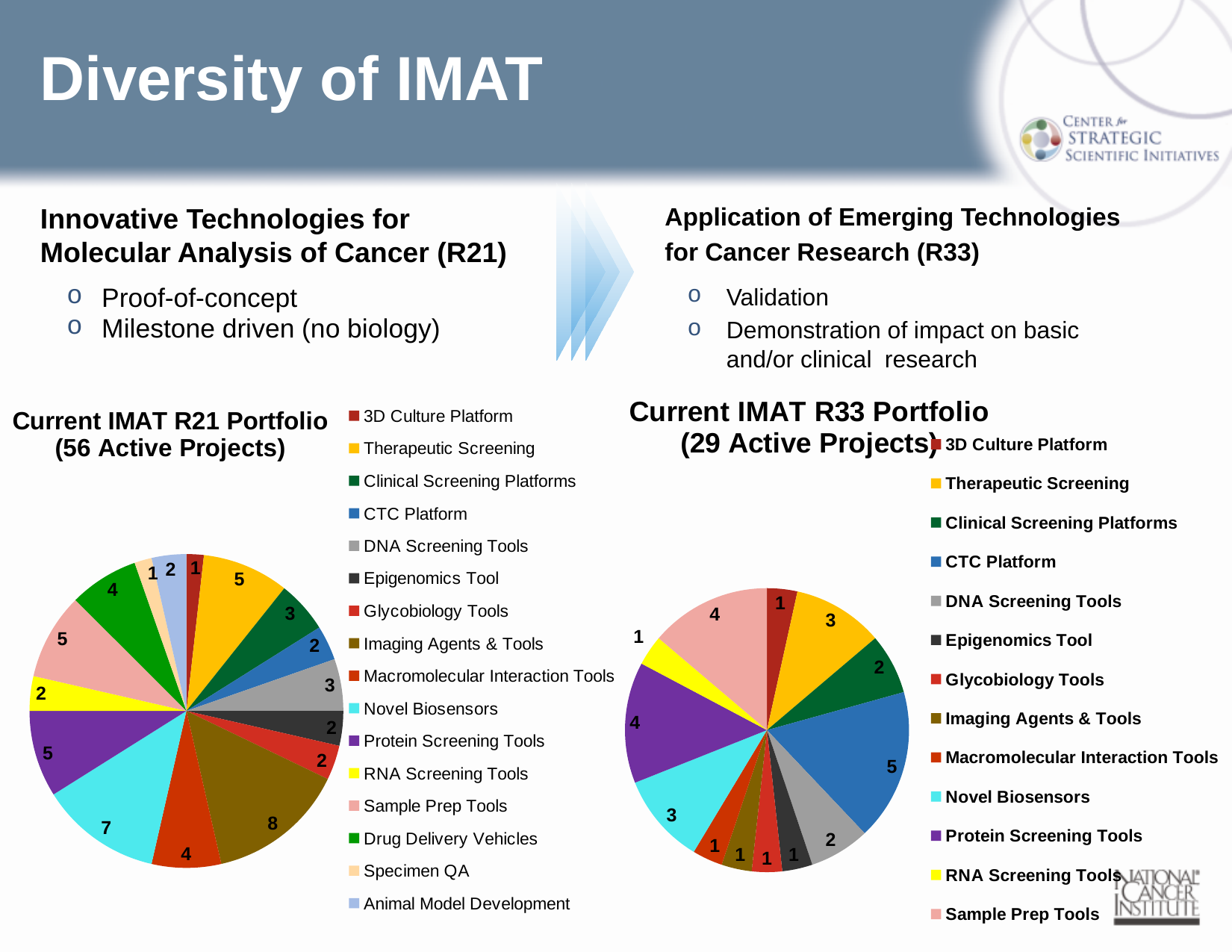
In the Current IMAT R33 Portfolio chart, which category has the largest slice? CTC Platform In the Current IMAT R21 Portfolio chart, what is the difference between Imaging Agents & Tools and Macromolecular Interaction Tools? 4 In the Current IMAT R33 Portfolio chart, how many projects are in CTC Platform? 5 What type of chart is used for the Current IMAT R33 Portfolio? Pie chart In the Current IMAT R21 Portfolio chart, how many projects are in Imaging Agents & Tools? 8 In the Current IMAT R33 Portfolio chart, which is larger, Therapeutic Screening or Protein Screening Tools? Protein Screening Tools In the Current IMAT R21 Portfolio chart, what share of the 56 projects is Novel Biosensors? 12.5% In the Current IMAT R33 Portfolio chart, how many categories does the legend list? 13 In the Current IMAT R21 Portfolio chart, how many categories does the legend list? 16 In the Current IMAT R21 Portfolio chart, how many projects are in Novel Biosensors? 7 Which chart has more active projects, the R21 Portfolio or the R33 Portfolio? R21 Portfolio In the Current IMAT R21 Portfolio chart, which category has the largest slice? Imaging Agents & Tools